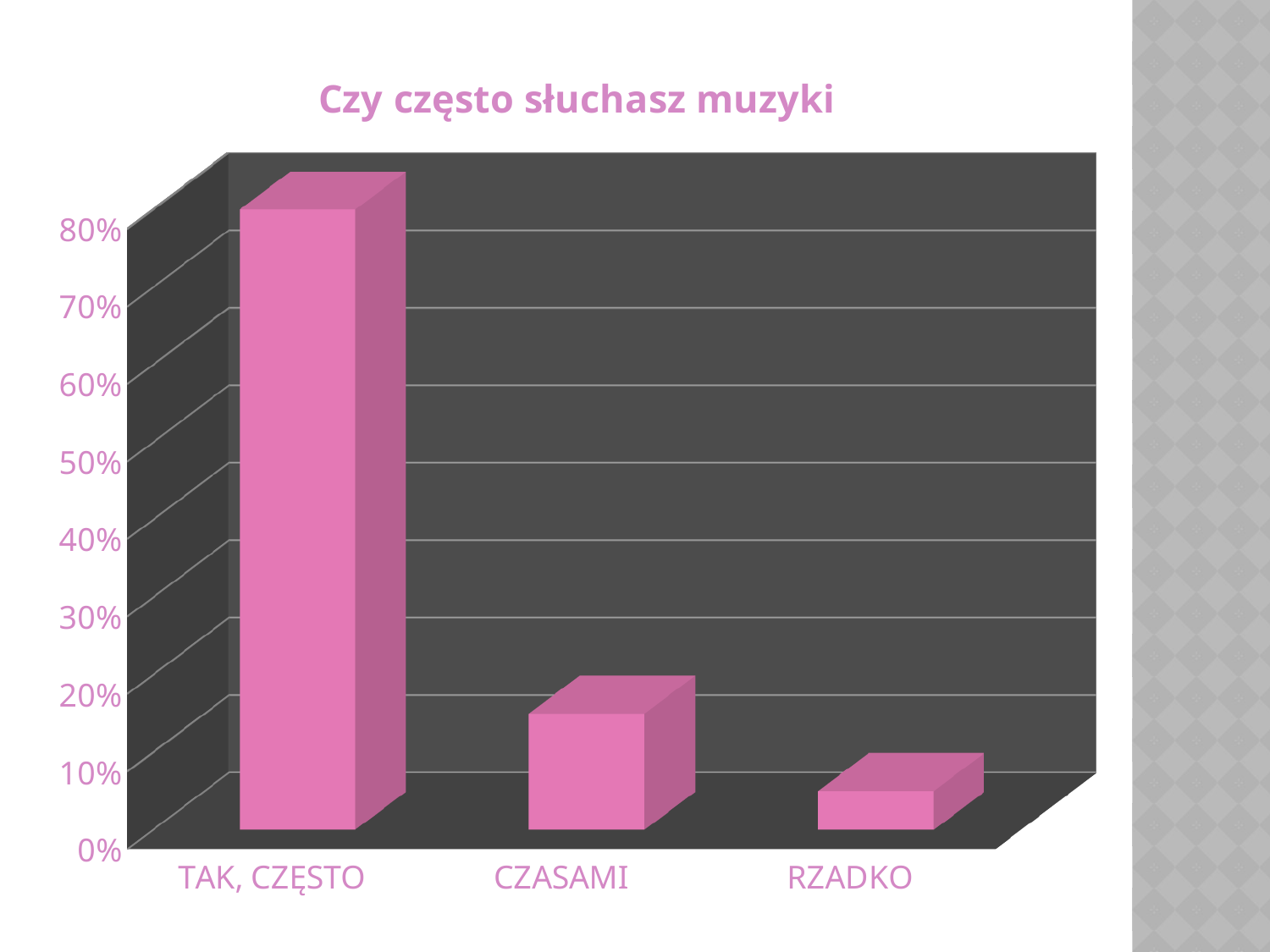
Do the values rise or fall from left to right along the x axis? fall Is the value for TAK, CZĘSTO greater or less than 70%? greater Is the value for CZASAMI greater or less than 10%? greater What is the title of the chart? Czy często słuchasz muzyki What kind of chart is shown on the slide? bar chart Is the value for RZADKO greater or less than 20%? less Which is larger, the value for CZASAMI or the value for RZADKO? CZASAMI How many categories are shown on the x axis of the chart? 3 Which category has the lowest value? RZADKO Which is larger, the value for TAK, CZĘSTO or the value for CZASAMI? TAK, CZĘSTO Which category has the highest value? TAK, CZĘSTO